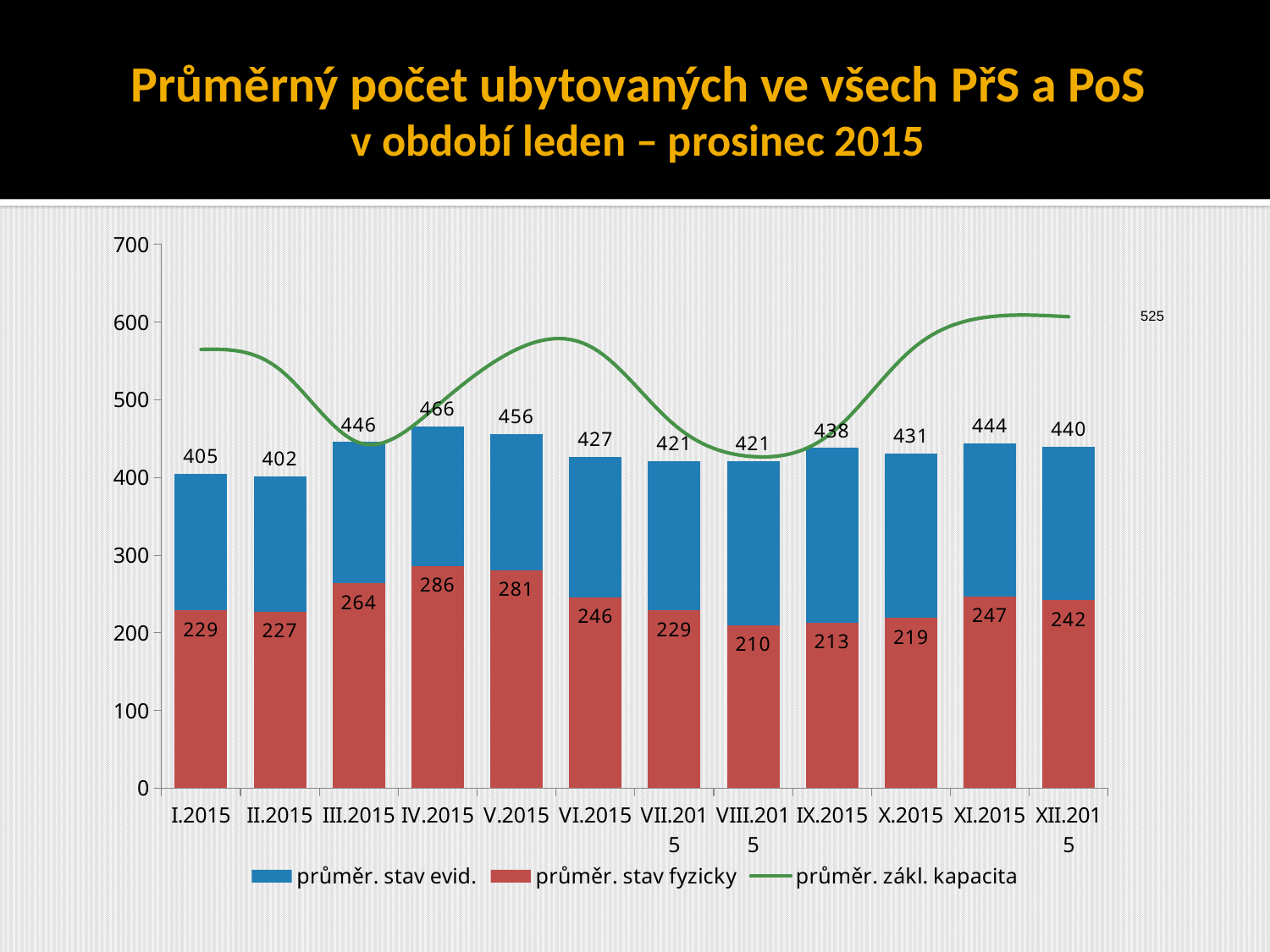
Which month has the lowest value for průměr. stav evid.? II.2015 What is the value of průměr. stav fyzicky for VIII.2015? 210 Which month has the highest value for průměr. stav evid.? IV.2015 How many series does the legend list? 3 Which month has the larger průměr. stav fyzicky value, III.2015 or V.2015? V.2015 How many months are shown on the x axis? 12 Which month has the highest value for průměr. stav fyzicky? IV.2015 Which month has the lowest value for průměr. stav fyzicky? VIII.2015 What is the value of průměr. stav evid. for IV.2015? 466 What kind of chart is shown on the slide? bar chart with a line Is the value of průměr. zákl. kapacita for I.2015 greater or less than 500? greater What is the difference between the průměr. stav evid. values for IV.2015 and II.2015? 64